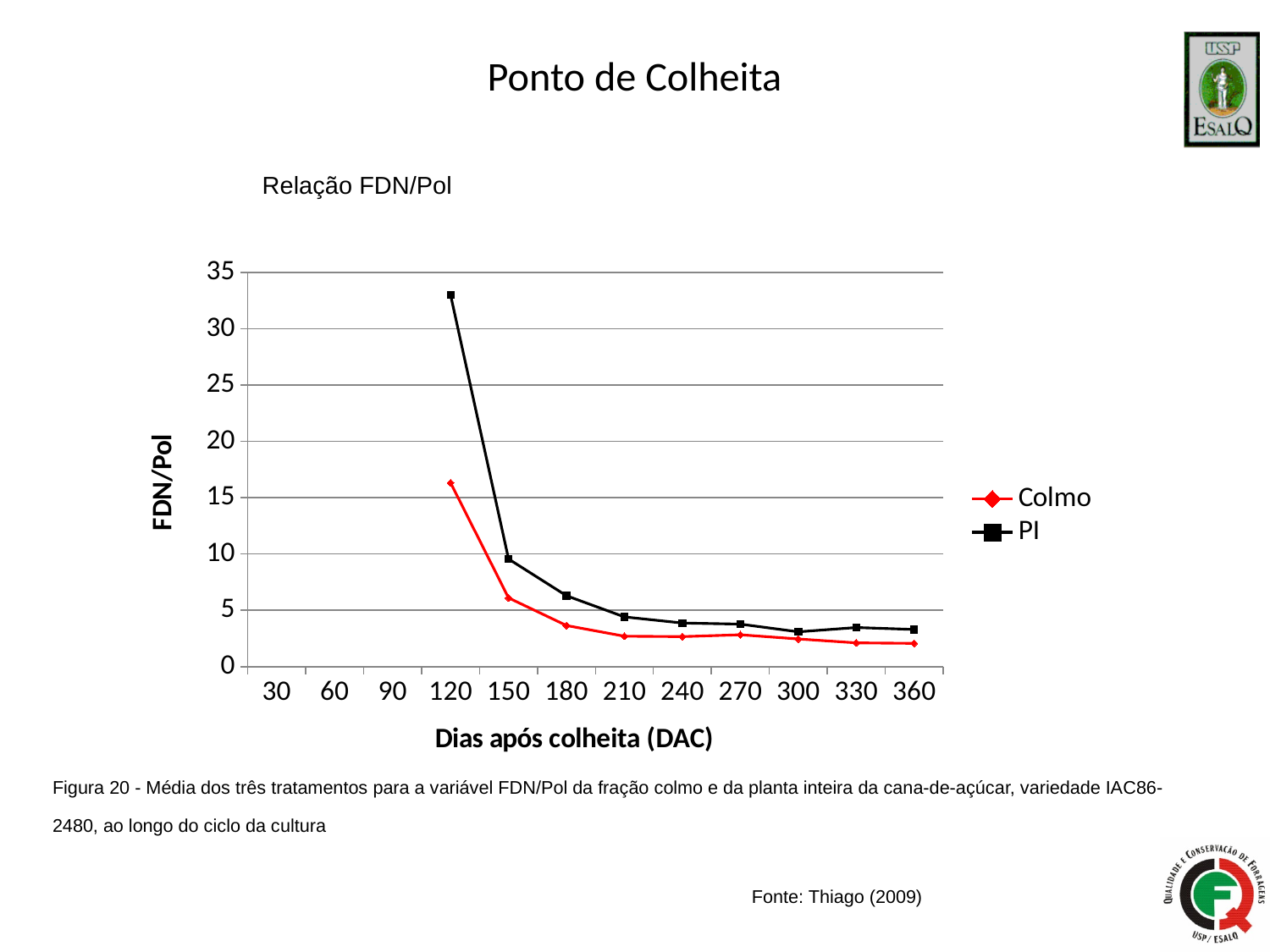
How many data points are plotted for the PI series? 9 Is the value for Colmo at 360 DAC greater or less than 5? less At which DAC value does the PI series reach its highest point? 120 At 180 DAC, which series has the larger value, Colmo or PI? PI At 120 DAC, which series has the larger value, Colmo or PI? PI What kind of chart is shown on the slide? line chart What is the label of the y axis? FDN/Pol How many series does the legend list? 2 Do the Colmo values rise or fall as days after harvest increase? fall Is the value for Colmo at 120 DAC greater or less than 15? greater Is the value for PI at 120 DAC greater or less than 30? greater